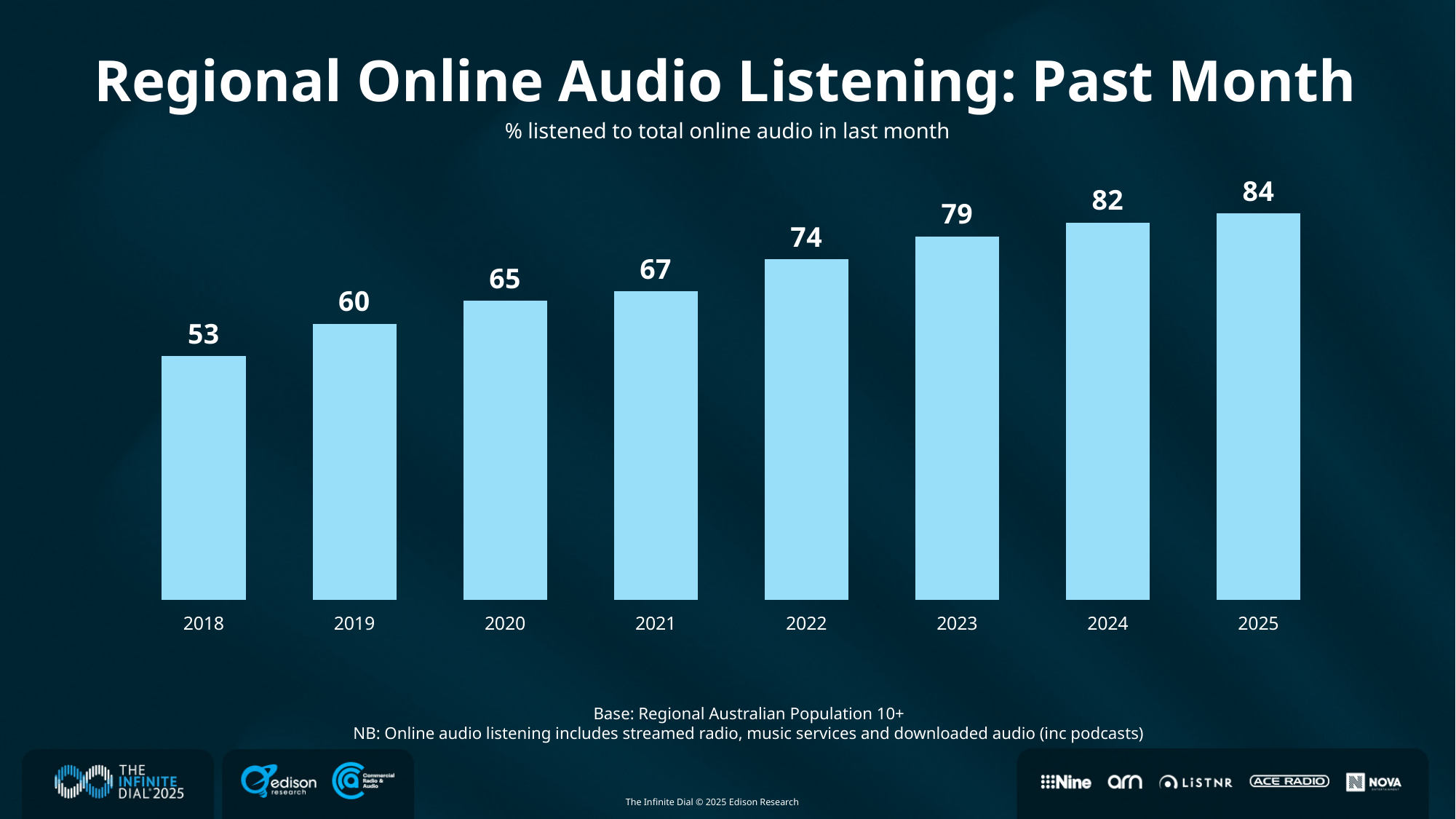
Which year has the highest value? 2025 Do the values rise or fall from 2018 to 2025? Rise What is the difference between the values for 2025 and 2018? 31 What is the value for 2018? 53 What is the value for 2022? 74 What is the difference between the values for 2023 and 2022? 5 What is the title of the chart? Regional Online Audio Listening: Past Month What is the value for 2025? 84 Which is larger, the value for 2020 or the value for 2021? 2021 What kind of chart is this? Bar chart Which year has the lowest value? 2018 How many years are shown on the chart? 8